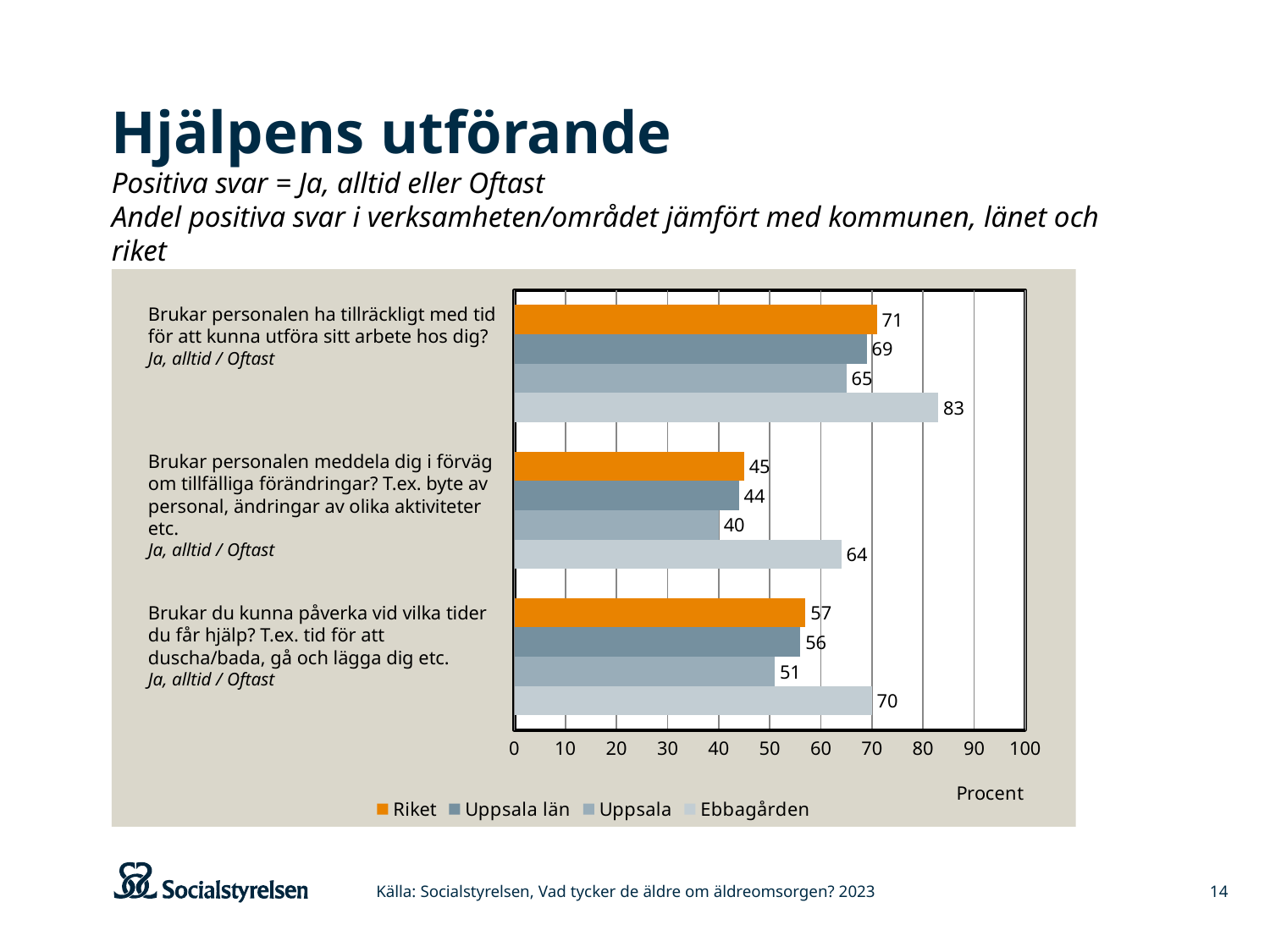
What is the value for Ebbagården on the question "Brukar personalen ha tillräckligt med tid för att kunna utföra sitt arbete hos dig?"? 83 How many questions (categories) are shown in the chart? 3 Which series has the lowest value on the question "Brukar personalen ha tillräckligt med tid för att kunna utföra sitt arbete hos dig?"? Uppsala Which series has the highest value on the question "Brukar personalen meddela dig i förväg om tillfälliga förändringar?"? Ebbagården What is the difference between Ebbagården and Uppsala on the question "Brukar personalen meddela dig i förväg om tillfälliga förändringar?"? 24 What unit is shown on the x axis of the chart? Procent What kind of chart is shown on the slide? Bar chart What is the difference between Ebbagården and Riket on the question "Brukar du kunna påverka vid vilka tider du får hjälp?"? 13 What is the value for Riket on the question "Brukar personalen meddela dig i förväg om tillfälliga förändringar?"? 45 What is the value for Uppsala on the question "Brukar du kunna påverka vid vilka tider du får hjälp?"? 51 Which is larger on the question "Brukar personalen ha tillräckligt med tid för att kunna utföra sitt arbete hos dig?": Riket or Ebbagården? Ebbagården How many series does the legend list? 4